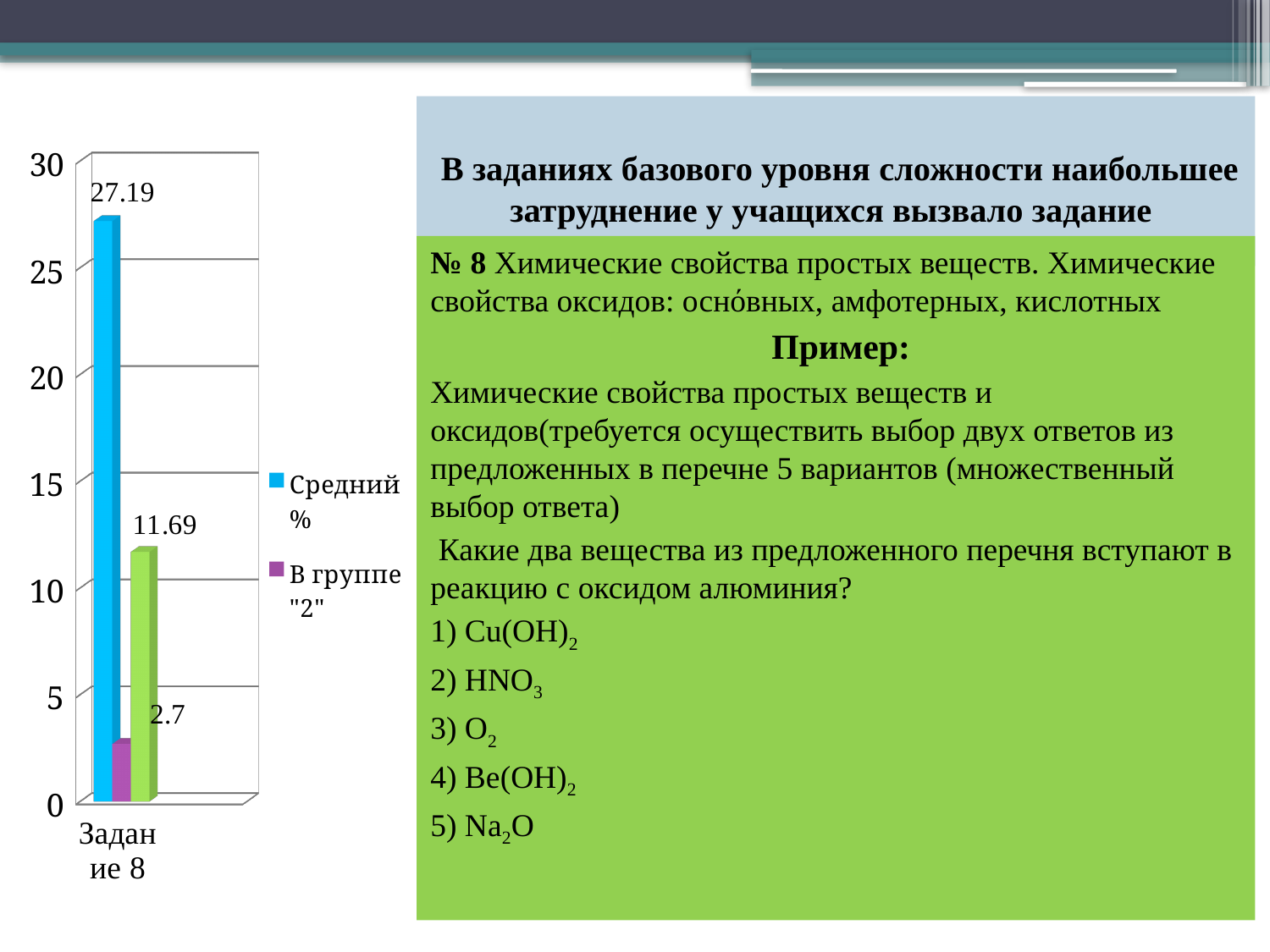
Is the value of the "В группе "2"" bar greater or less than 5? less Which series has the tallest bar in the chart? Средний % What is the difference between the "Средний %" value and the "В группе "2"" value for Задание 8? 24.49 What is the value of the "Средний %" bar for Задание 8? 27.19 How many categories are shown on the x axis of the chart? 1 What is the category label shown on the x axis of the chart? Задание 8 How many series does the chart's legend list? 2 What is the value of the "В группе "2"" bar for Задание 8? 2.7 Is the value of the "Средний %" bar greater or less than 25? greater What kind of chart is shown on the slide? bar chart Which is larger for Задание 8: "Средний %" or "В группе "2""? Средний % Which series has the shortest bar in the chart? В группе "2"